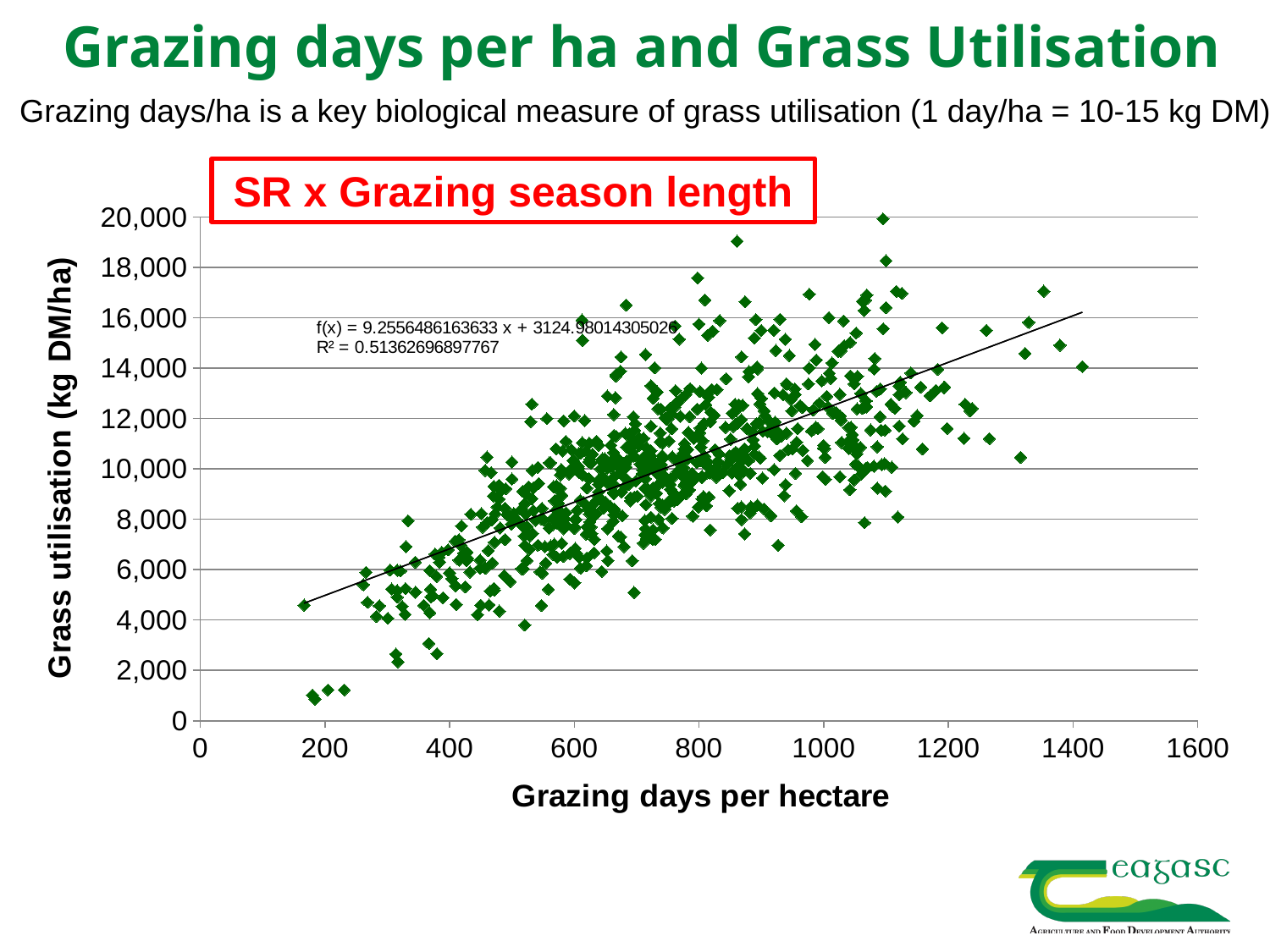
Is the smallest grazing days per hectare value among the plotted points greater or less than 400? less What R² value is printed on the chart for the fitted line? 0.513362696897767 What is the label of the x axis? Grazing days per hectare As grazing days per hectare increase, does grass utilisation generally rise or fall? Rise Is the largest grazing days per hectare value among the plotted points greater or less than 1200? greater What is the slope (coefficient of x) in the fitted line equation printed on the chart? 9.2556486163633 What is the label of the y axis? Grass utilisation (kg DM/ha) What kind of chart is shown on the slide? Scatter chart Is the grass utilisation of the lowest plotted point greater or less than 2,000? less